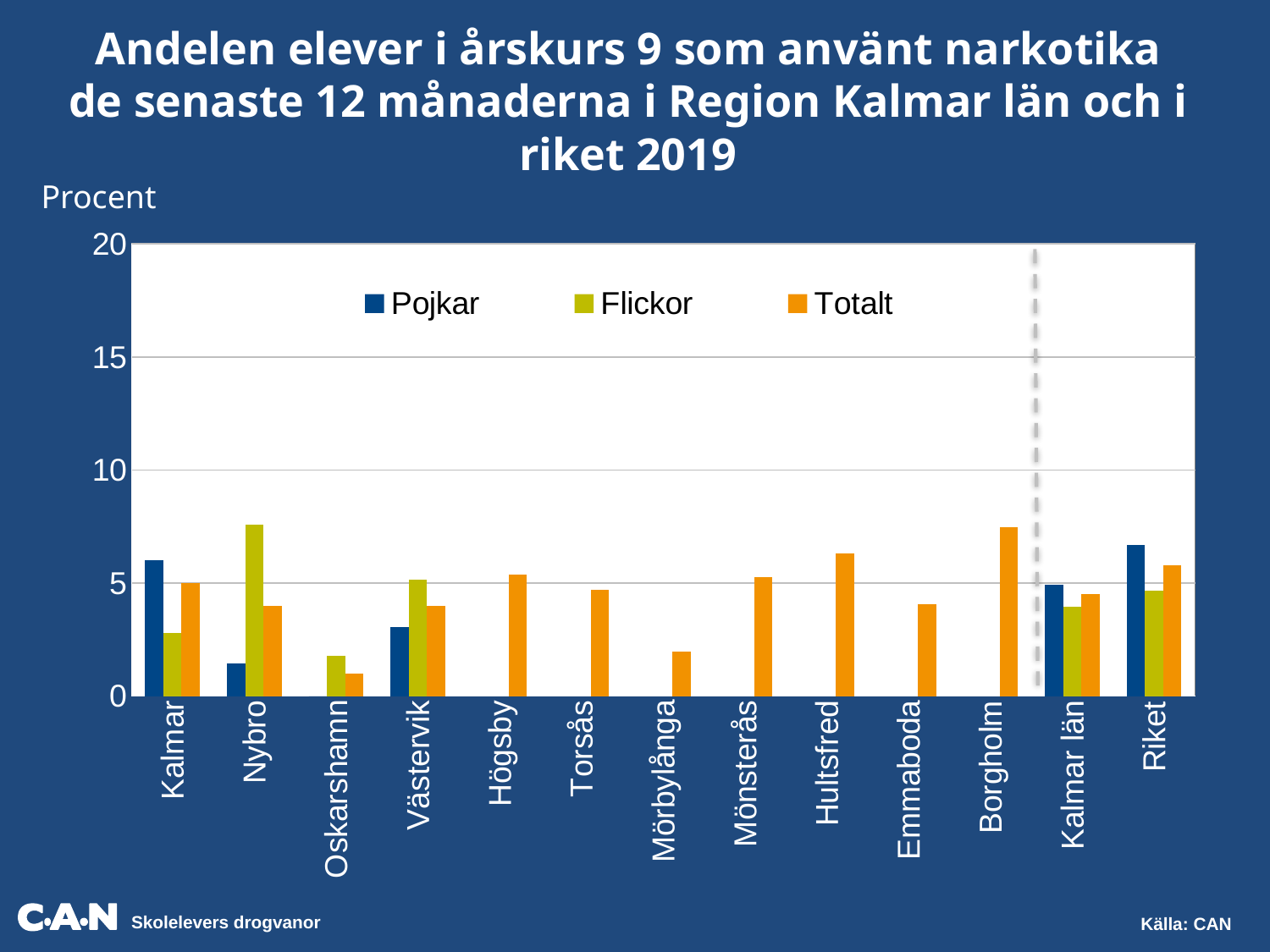
How many series does the legend list? 3 Which category has the lowest Totalt value? Oskarshamn How many categories are shown along the x axis? 13 Which category has the highest Flickor value? Nybro Which category has the highest Totalt value? Borgholm What kind of chart is shown on the slide? bar chart Is the Totalt value for Borgholm greater or less than 5? greater Is the Totalt value for Mörbylånga greater or less than 5? less Is the Flickor value for Nybro greater or less than 5? greater What label is shown on the y axis of the chart? Procent Which has the larger Totalt value, Hultsfred or Emmaboda? Hultsfred For Kalmar, which is larger, the Pojkar value or the Flickor value? Pojkar